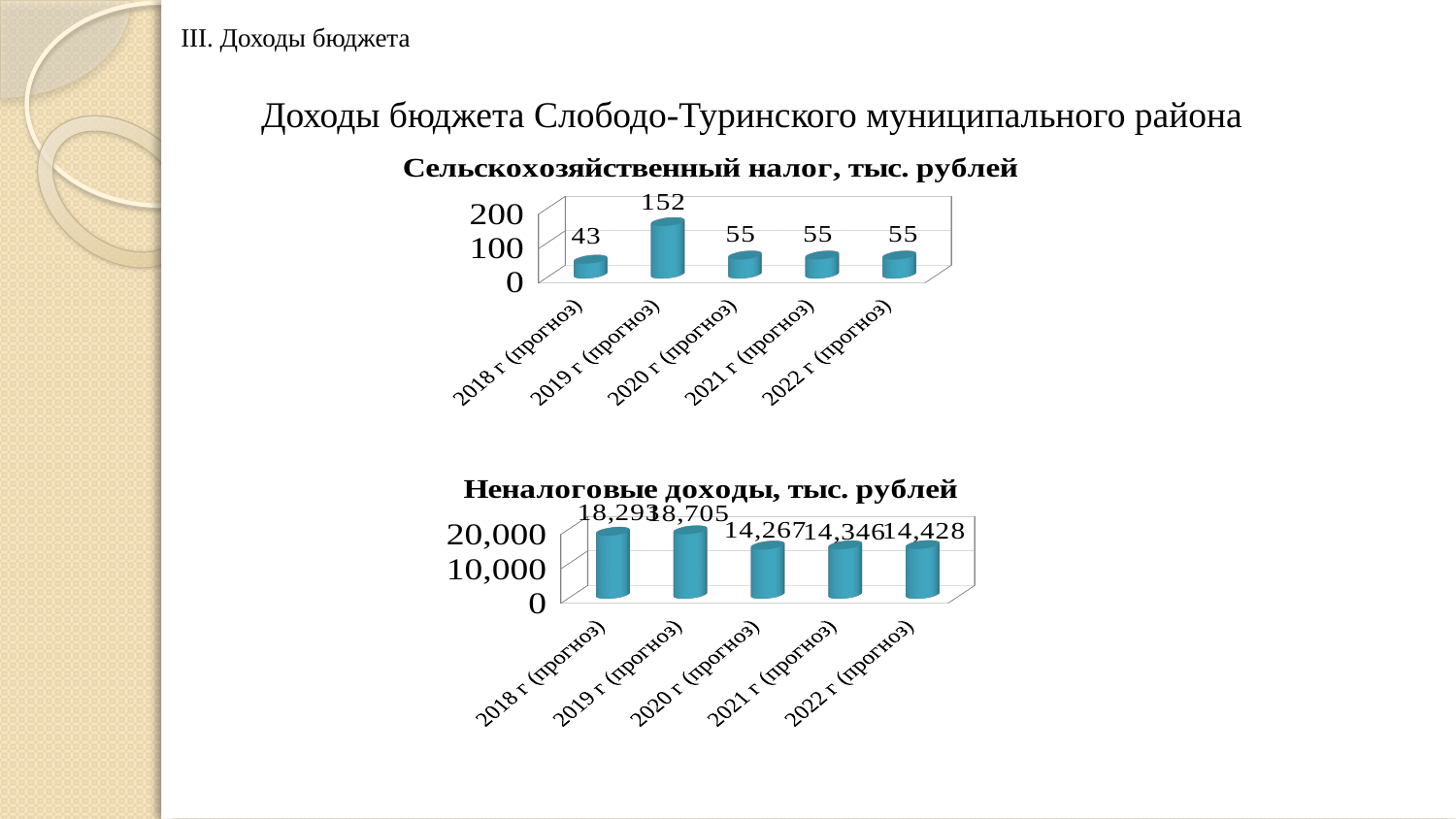
In the chart titled 'Неналоговые доходы, тыс. рублей', what is the value for 2019 г (прогноз)? 18,705 In the chart titled 'Сельскохозяйственный налог, тыс. рублей', what is the value for 2018 г (прогноз)? 43 In the chart titled 'Сельскохозяйственный налог, тыс. рублей', how many years are shown on the x axis? 5 In the chart titled 'Неналоговые доходы, тыс. рублей', is the value for 2022 г (прогноз) larger or smaller than the value for 2019 г (прогноз)? smaller What kind of chart is the chart titled 'Неналоговые доходы, тыс. рублей'? bar chart In the chart titled 'Неналоговые доходы, тыс. рублей', what is the value for 2020 г (прогноз)? 14,267 In the chart titled 'Сельскохозяйственный налог, тыс. рублей', which year has the lowest value? 2018 г (прогноз) In the chart titled 'Неналоговые доходы, тыс. рублей', which year has the highest value? 2019 г (прогноз) In the chart titled 'Неналоговые доходы, тыс. рублей', which year has the lowest value? 2020 г (прогноз) In the chart titled 'Сельскохозяйственный налог, тыс. рублей', which year has the highest value? 2019 г (прогноз) In the chart titled 'Сельскохозяйственный налог, тыс. рублей', what is the difference between the values for 2019 г (прогноз) and 2020 г (прогноз)? 97 In the chart titled 'Сельскохозяйственный налог, тыс. рублей', what is the value for 2019 г (прогноз)? 152